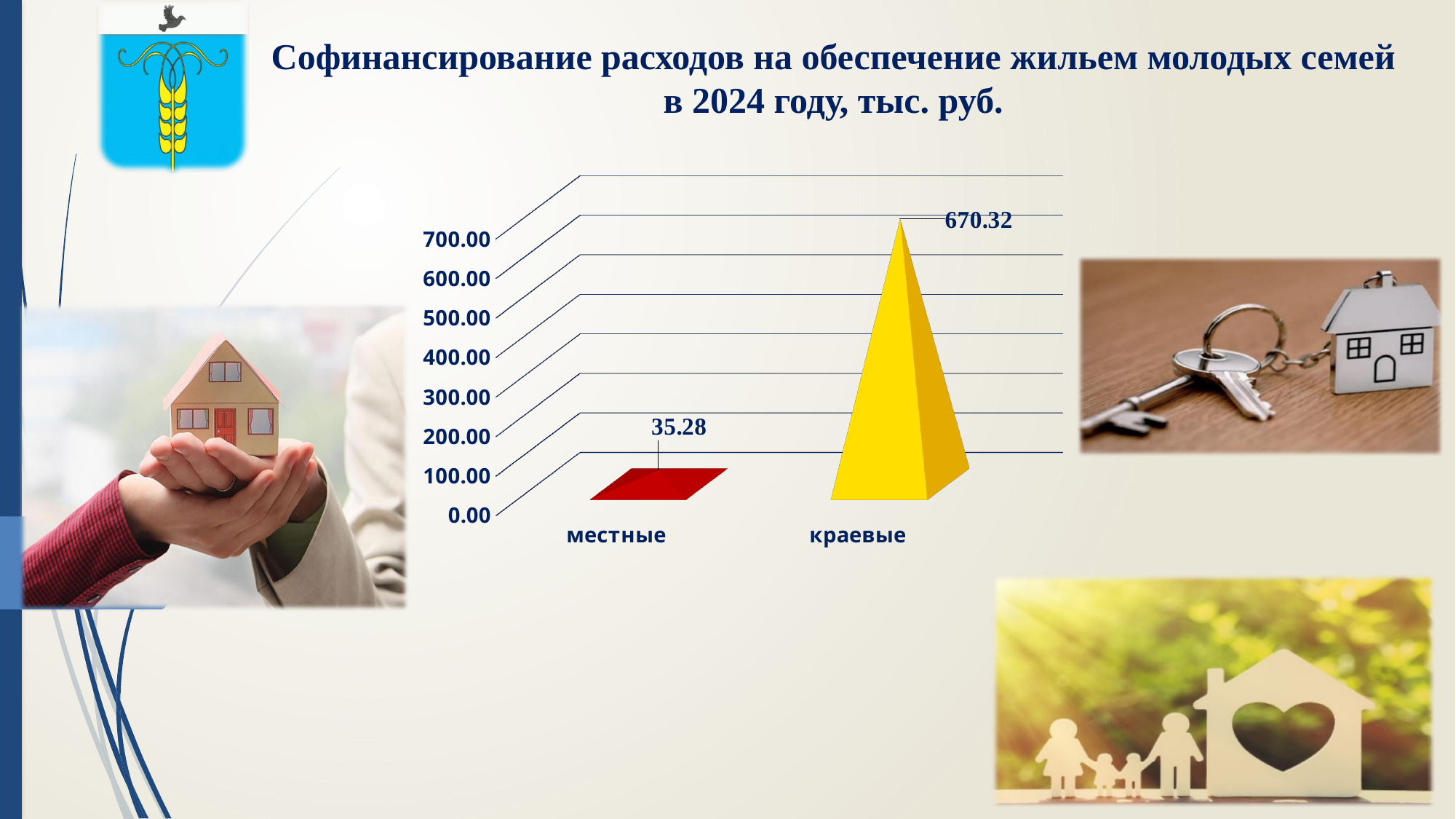
Is the value for местные greater or less than 100.00? less What kind of chart is shown on the slide? bar chart What is the value for местные? 35.28 What is the difference between the values for краевые and местные? 635.04 Which category has the highest value? краевые What is the title of the chart on the slide? Софинансирование расходов на обеспечение жильем молодых семей в 2024 году, тыс. руб. What is the value for краевые? 670.32 Which is larger, the value for местные or the value for краевые? краевые How many categories are shown on the chart? 2 Which category has the lowest value? местные What colour is the bar for краевые? yellow Is the value for краевые greater or less than 600.00? greater